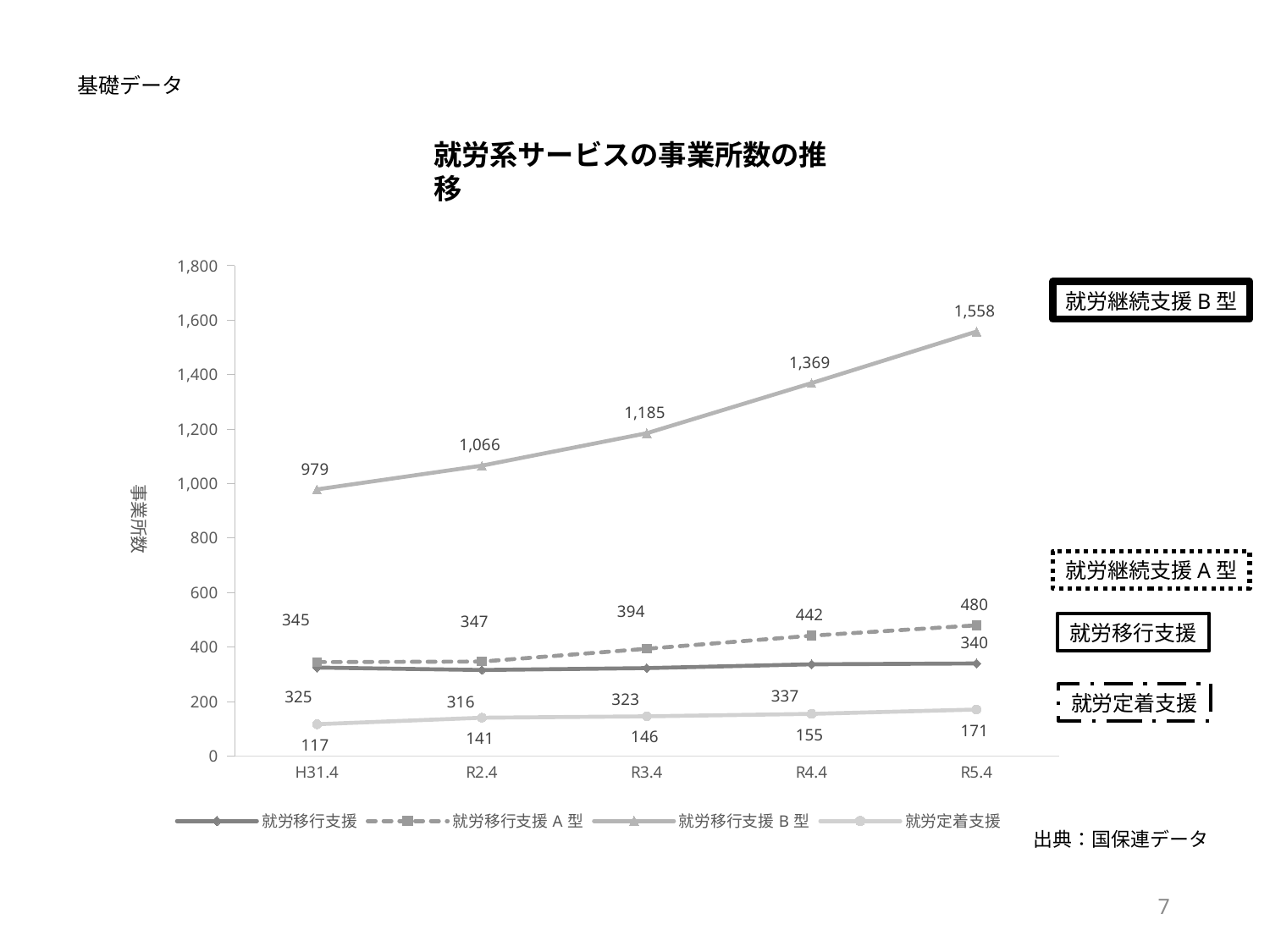
Which is larger at R4.4: 就労移行支援A型 or 就労移行支援? 就労移行支援A型 Which series has the highest value at R5.4? 就労移行支援B型 How many time points are plotted along the x axis? 5 What is the value for 就労移行支援A型 at R3.4? 394 What is the value for 就労移行支援B型 at R5.4? 1,558 Which series has the lowest value at H31.4? 就労定着支援 How many series does the legend list? 4 What is the value for 就労移行支援 at R2.4? 316 Does the value for 就労移行支援B型 rise or fall from H31.4 to R5.4? rise What is the value for 就労定着支援 at H31.4? 117 What is the difference between the 就労移行支援B型 values at R5.4 and H31.4? 579 What type of chart is shown on the slide? line chart